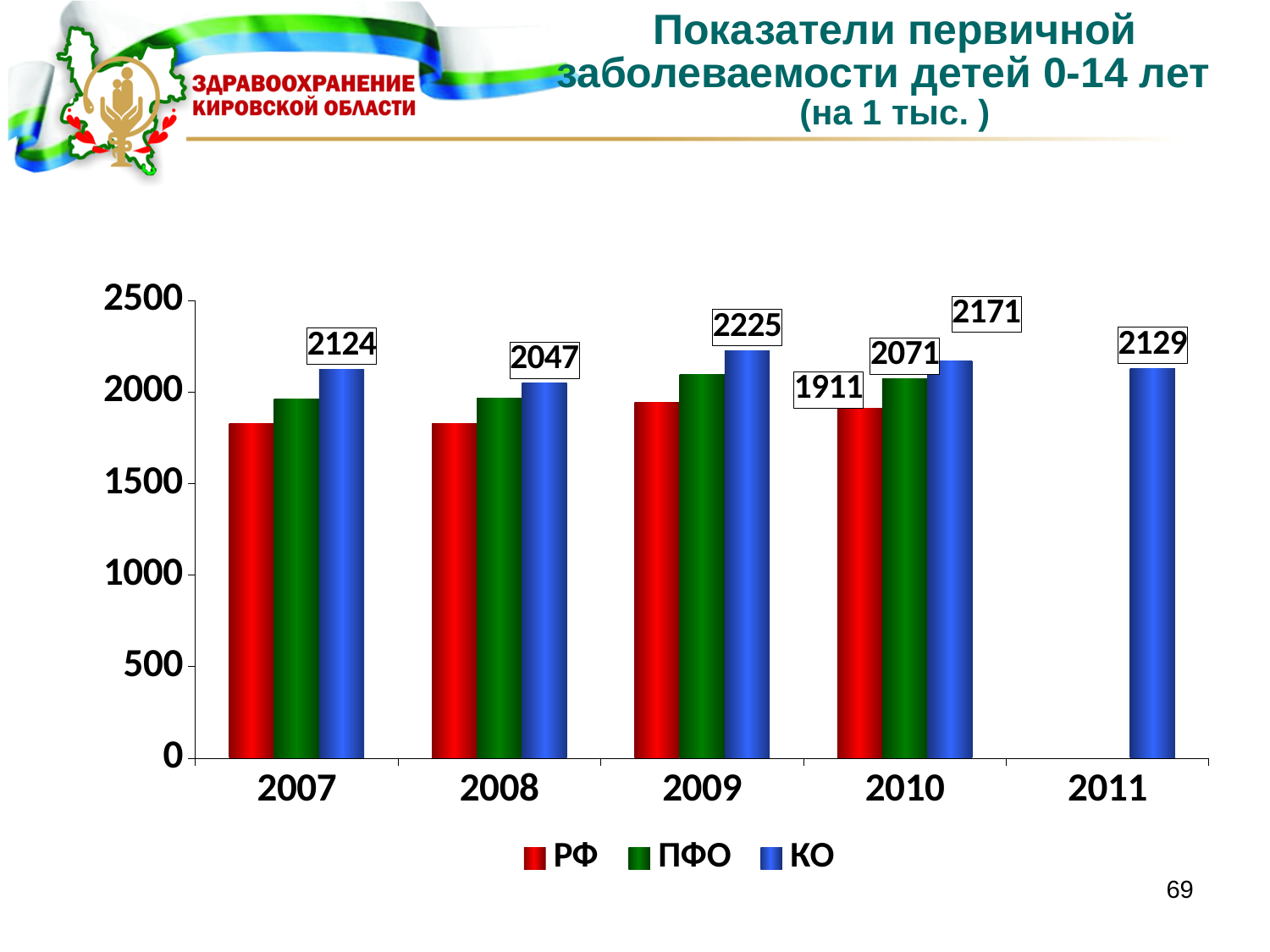
What kind of chart is shown on the slide? bar chart What is the difference between the КО value in 2009 and the КО value in 2008? 178 Is the value for РФ in 2007 greater or less than 2000? less What is the value for КО in 2011? 2129 In 2010, which is larger: the value for КО or the value for РФ? КО In which year is the КО value highest? 2009 How many series does the legend list? 3 What is the value for КО in 2009? 2225 In which year is the КО value lowest? 2008 What is the value for КО in 2007? 2124 What is the value for РФ in 2010? 1911 What is the value for ПФО in 2010? 2071